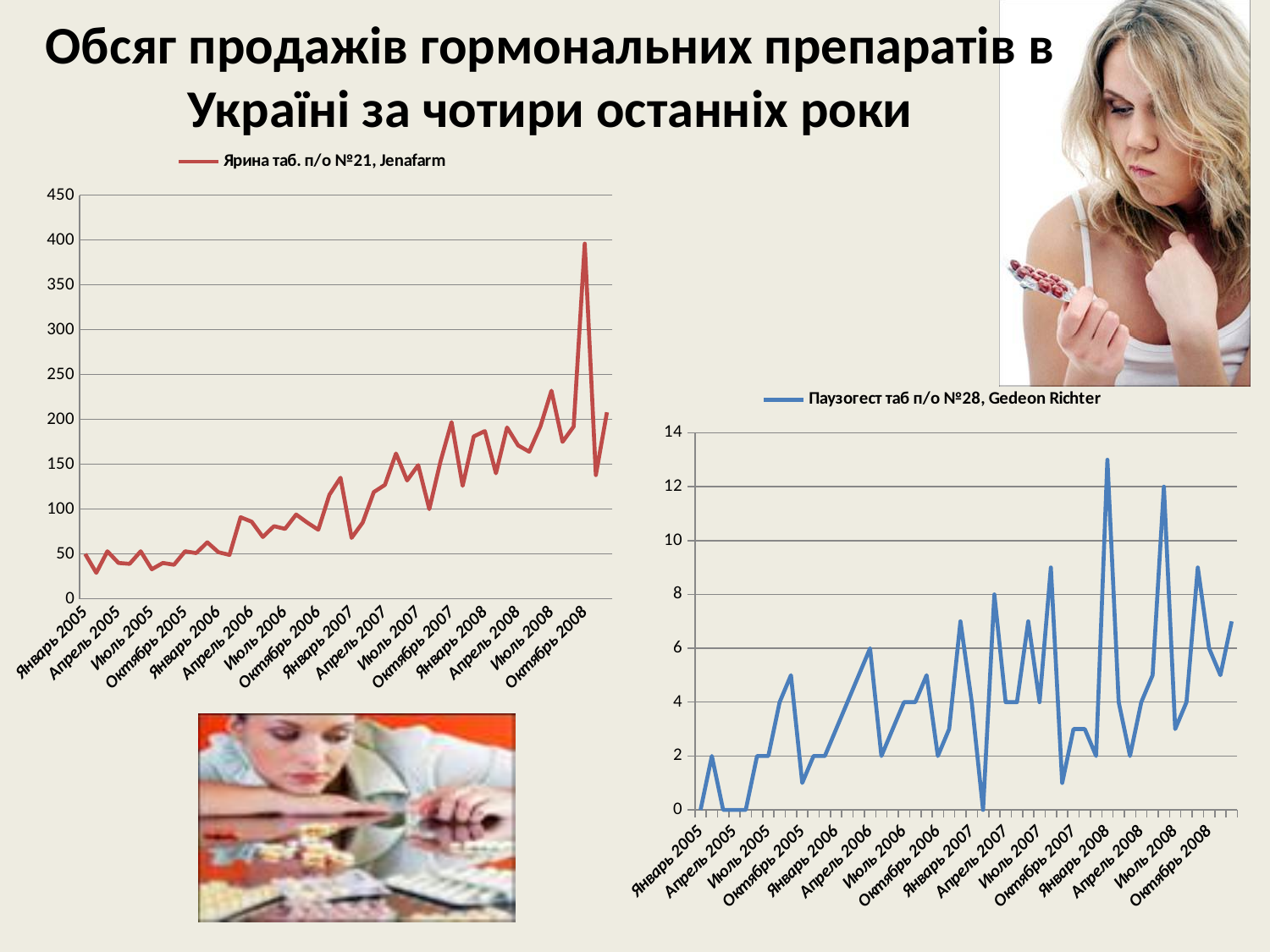
In the left chart (Ярина), is the value for Январь 2008 greater or less than 150? greater In the right chart (Паузогест), is the value for Январь 2008 greater or less than 10? greater In the left chart (Ярина), is the value for Январь 2006 greater or less than 100? less What colour is the line in the right chart (Паузогест)? blue What kind of chart is the right chart titled "Паузогест таб п/о №28, Gedeon Richter"? line chart How many series does the legend of the left chart (Ярина) list? 1 What kind of chart is the left chart titled "Ярина таб. п/о №21, Jenafarm"? line chart In the left chart (Ярина), do the values generally rise or fall from Январь 2005 to Октябрь 2008? rise In the right chart (Паузогест), do the values generally rise or fall from Январь 2005 to Октябрь 2008? rise How many series does the legend of the right chart (Паузогест) list? 1